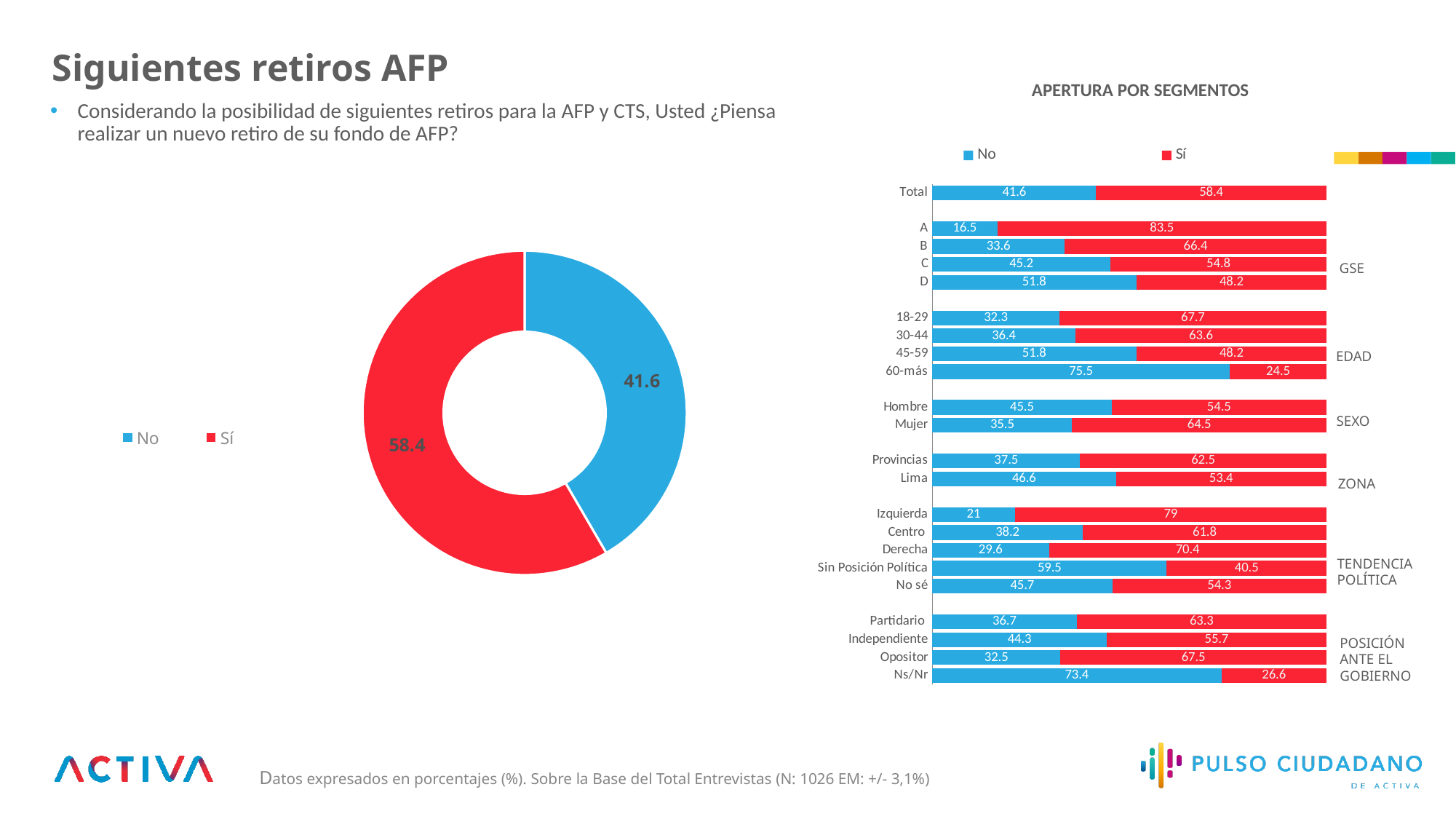
In the "APERTURA POR SEGMENTOS" chart, what is the total of the stacked bar for Izquierda? 100 What kind of chart is the chart on the left of the slide? Pie (donut) chart In the "APERTURA POR SEGMENTOS" chart, what is the "Sí" value for segment A? 83.5 In the "APERTURA POR SEGMENTOS" chart, what is the difference between the "Sí" values for Mujer and Hombre? 10 In the donut chart on the left, what percentage of respondents answered "No"? 41.6 In the "APERTURA POR SEGMENTOS" chart, what is the "No" value for the 60-más age group? 75.5 In the "APERTURA POR SEGMENTOS" chart, which has a larger "Sí" value, Provincias or Lima? Provincias In the "APERTURA POR SEGMENTOS" chart, which segment has the lowest "No" value? A In the "APERTURA POR SEGMENTOS" chart, which segment has the highest "No" value? 60-más In the donut chart on the left, what percentage of respondents answered "Sí"? 58.4 What kind of chart is the "APERTURA POR SEGMENTOS" chart? Stacked bar chart How many series does the legend of the "APERTURA POR SEGMENTOS" chart list? 2